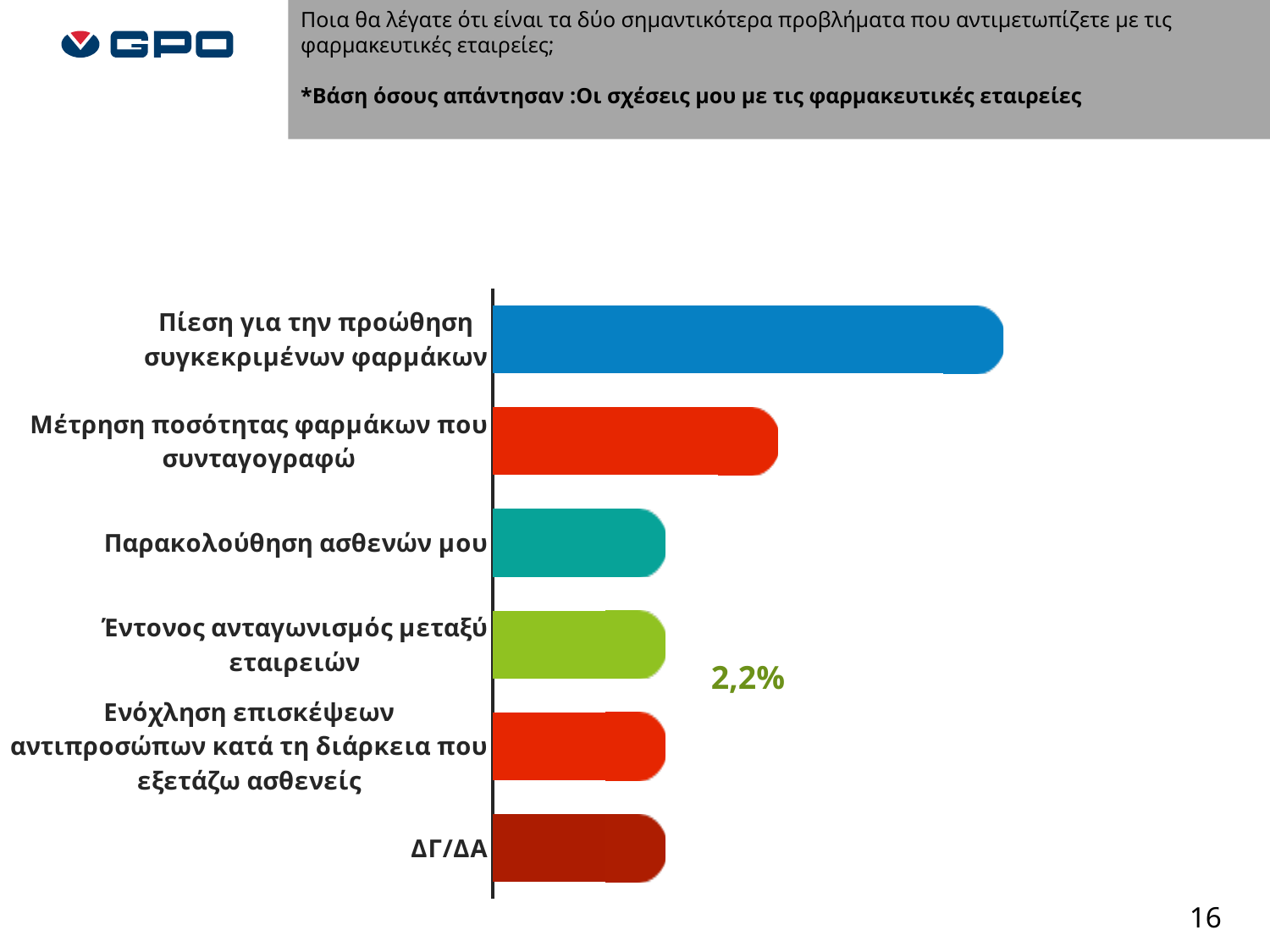
What is the label of the bottom-most category in the chart? ΔΓ/ΔΑ What kind of chart is shown on the slide? Bar chart Are the bars in the chart horizontal or vertical? Horizontal Which category has the second-longest bar in the chart? Μέτρηση ποσότητας φαρμάκων που συνταγογραφώ Which is larger: the bar for 'Πίεση για την προώθηση συγκεκριμένων φαρμάκων' or the bar for 'ΔΓ/ΔΑ'? Πίεση για την προώθηση συγκεκριμένων φαρμάκων Which is larger: the bar for 'Πίεση για την προώθηση συγκεκριμένων φαρμάκων' or the bar for 'Μέτρηση ποσότητας φαρμάκων που συνταγογραφώ'? Πίεση για την προώθηση συγκεκριμένων φαρμάκων How many categories are plotted in the chart? 6 Which is larger: the bar for 'Μέτρηση ποσότητας φαρμάκων που συνταγογραφώ' or the bar for 'Παρακολούθηση ασθενών μου'? Μέτρηση ποσότητας φαρμάκων που συνταγογραφώ Which category has the longest bar in the chart? Πίεση για την προώθηση συγκεκριμένων φαρμάκων